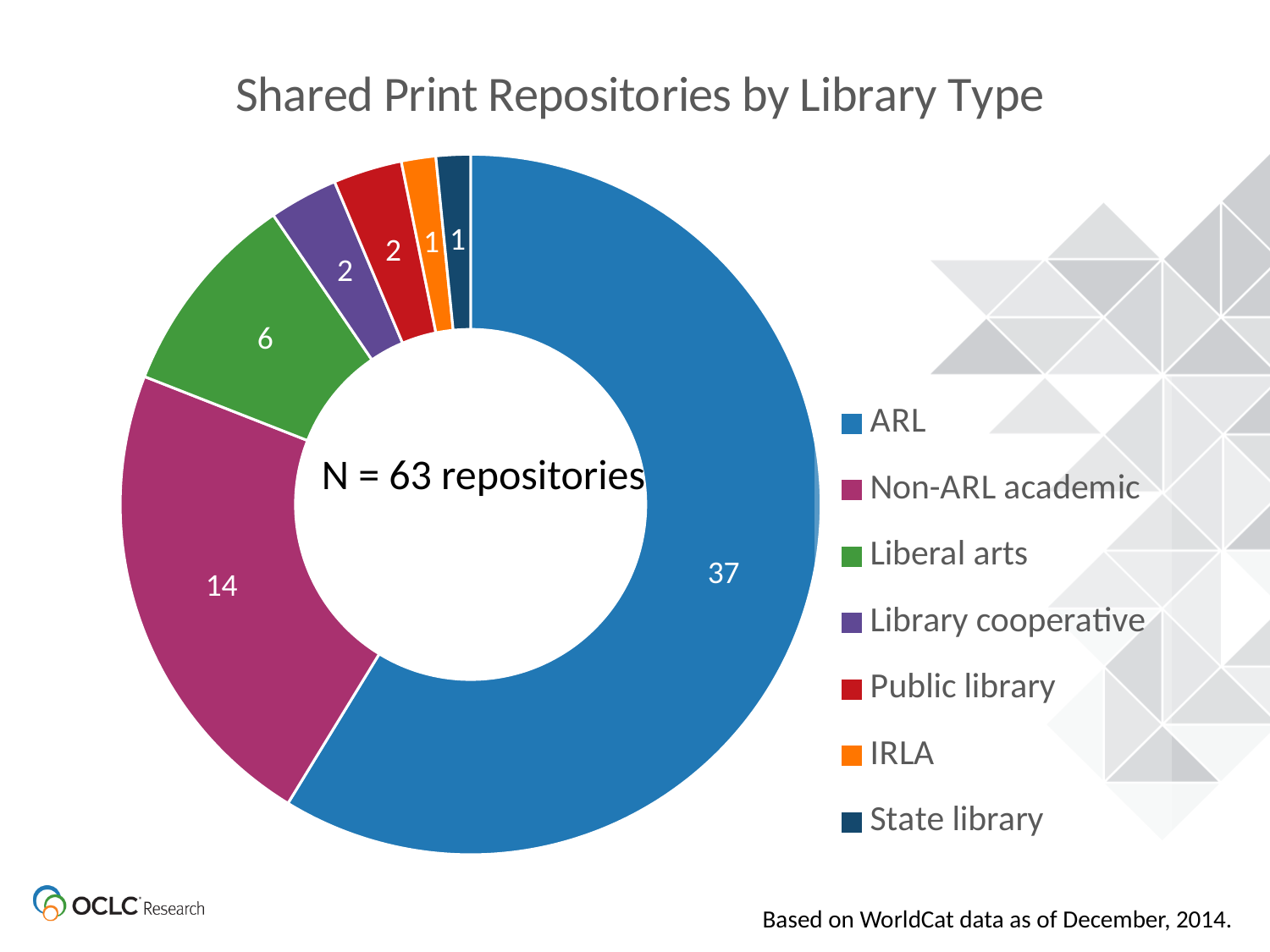
Which is larger, the Liberal arts value or the Library cooperative value? Liberal arts How many repositories are in the Non-ARL academic category? 14 Which library type has the largest number of shared print repositories? ARL How many repositories are in the ARL category? 37 What is the difference between the ARL and Non-ARL academic values? 23 What is the total number of repositories represented in the chart? 63 What colour represents the Public library category? Red How many repositories are in the Liberal arts category? 6 What is the title of the chart? Shared Print Repositories by Library Type How many repositories are in the IRLA category? 1 What type of chart is shown on the slide? Doughnut (pie) chart How many library types are shown in the legend? 7